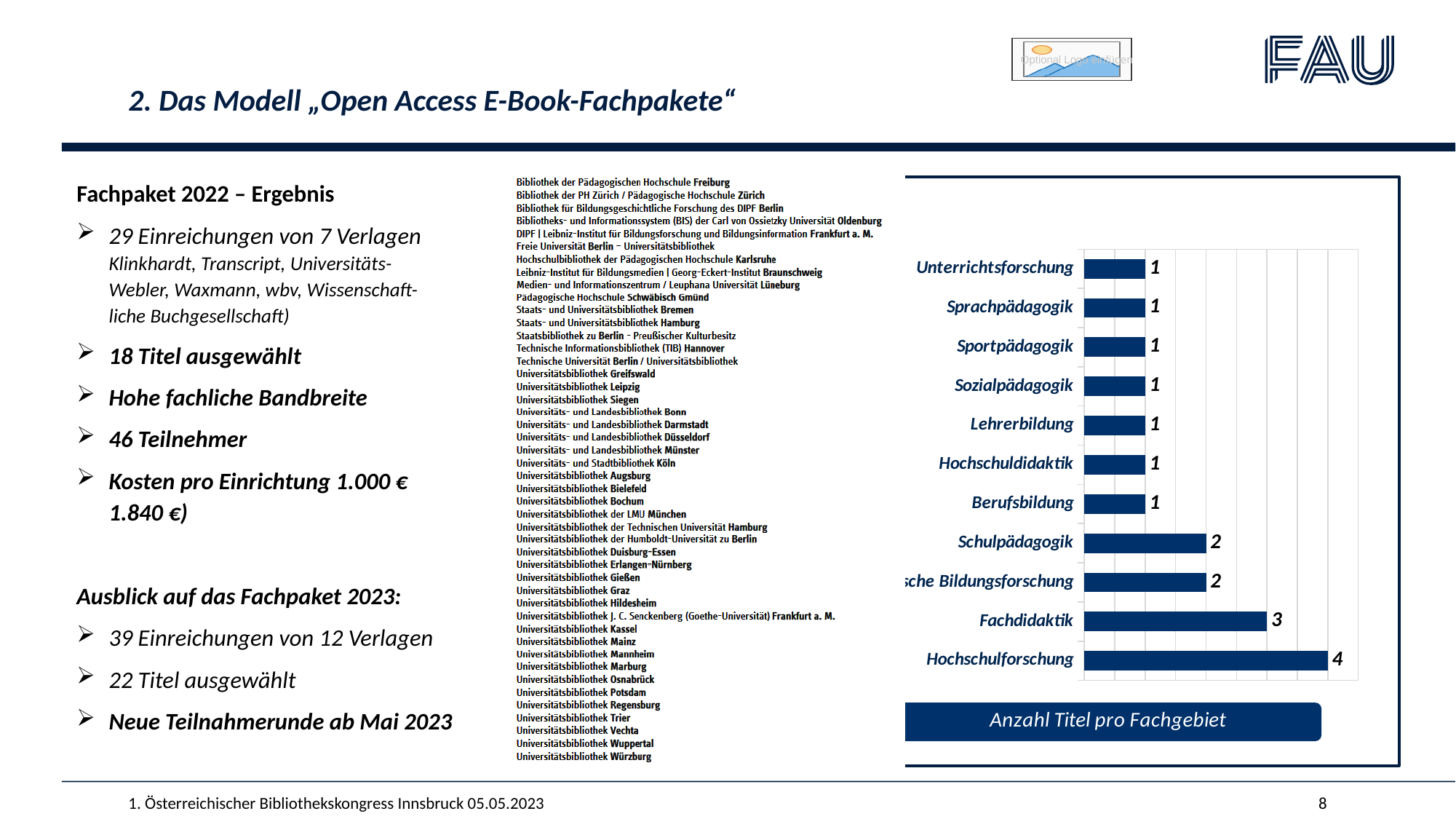
How many titles does the chart show for Fachdidaktik? 3 Which Fachgebiet has the highest number of titles in the chart? Hochschulforschung How many titles does the chart show for Schulpädagogik? 2 What kind of chart is shown on the slide? bar chart How many categories (Fachgebiete) are shown in the chart? 11 Which has more titles in the chart, Schulpädagogik or Sportpädagogik? Schulpädagogik What is the difference between the number of titles for Hochschulforschung and for Fachdidaktik? 1 What is the difference between the number of titles for Fachdidaktik and for Berufsbildung? 2 What is the title shown beneath the chart? Anzahl Titel pro Fachgebiet How many categories in the chart have a value of 1? 7 How many titles does the chart show for Hochschulforschung? 4 How many titles does the chart show for Lehrerbildung? 1